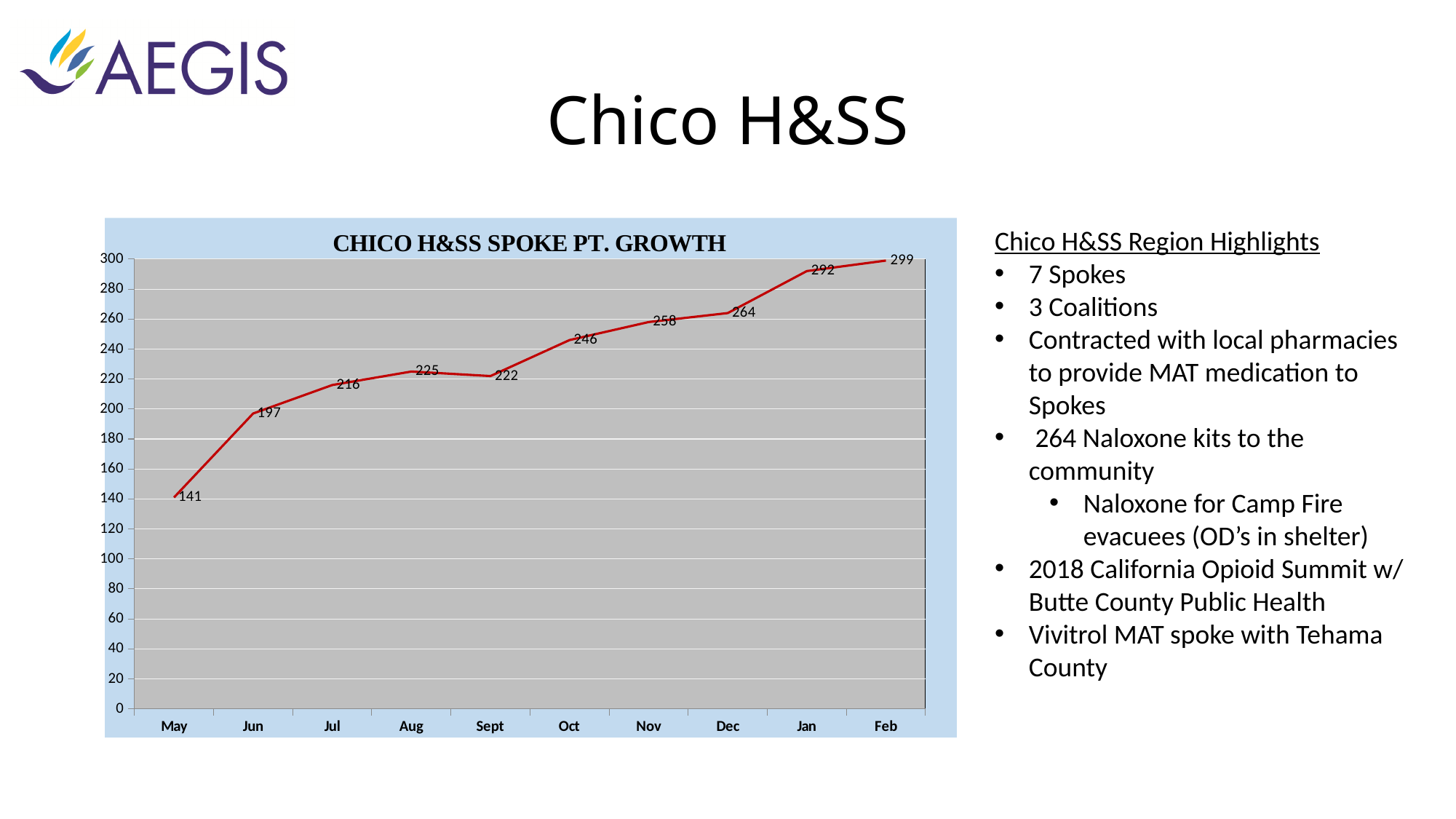
What is the difference between the values for Feb and May? 158 Which month has the highest value? Feb Do the values generally rise or fall from May to Feb? Rise What is the value for May? 141 What kind of chart is shown? Line chart What is the difference between the values for Jun and May? 56 How many months are plotted on the chart? 10 What is the value for Sept? 222 Which month has the lowest value? May What is the value for Jan? 292 Which is larger, the value for Aug or the value for Sept? Aug What is the title of the chart? CHICO H&SS SPOKE PT. GROWTH